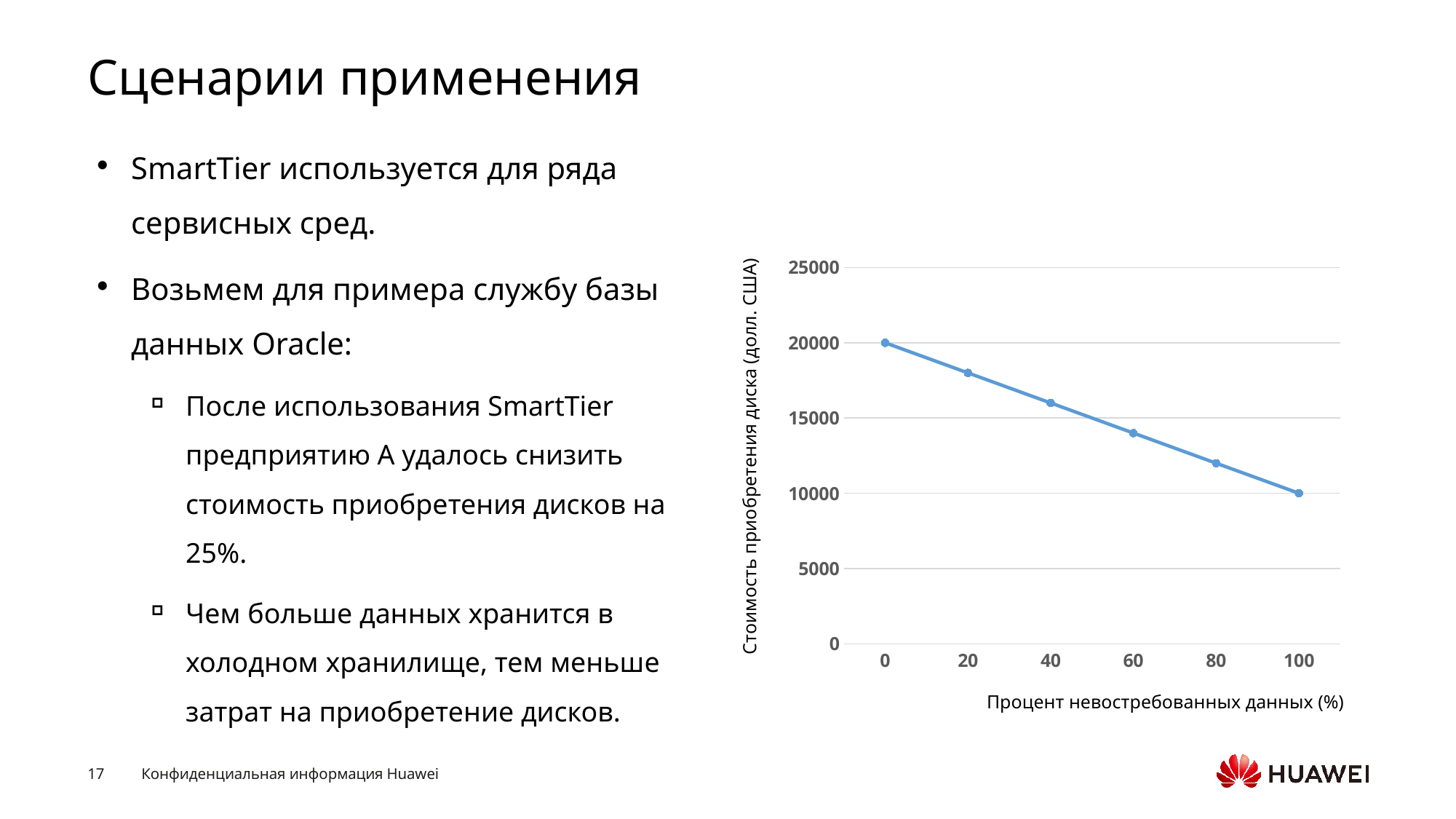
What is the label of the x axis of the chart? Процент невостребованных данных (%) What kind of chart is shown on the slide? line chart Does the disk acquisition cost rise or fall as the percentage of unused data increases? fall Which has a higher disk acquisition cost: 40% unused data or 60% unused data? 40 Is the disk acquisition cost at 80% unused data greater or less than 15000? less Is the disk acquisition cost at 20% unused data greater or less than 15000? greater What is the disk acquisition cost when the percentage of unused data is 100? 10000 What is the difference between the disk acquisition cost at 0% unused data and at 100% unused data? 10000 What is the disk acquisition cost when the percentage of unused data is 0? 20000 At which percentage of unused data is the disk acquisition cost lowest? 100 At which percentage of unused data is the disk acquisition cost highest? 0 How many data points are plotted on the line? 6